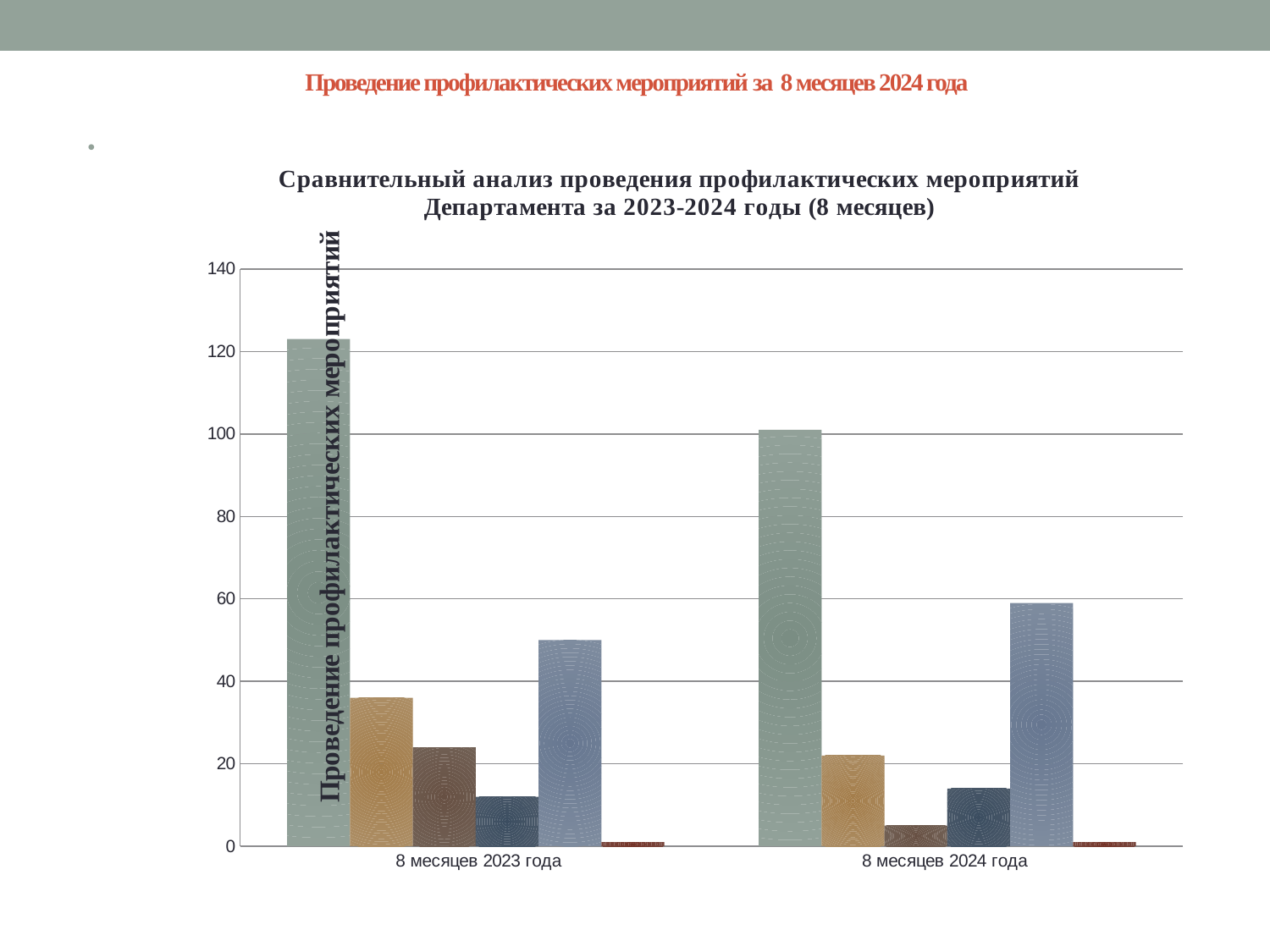
Is the tallest bar for "8 месяцев 2024 года" greater or less than 120? less Is the dark blue bar for "8 месяцев 2023 года" greater or less than 20? less What is the title of the chart? Сравнительный анализ проведения профилактических мероприятий Департамента за 2023-2024 годы (8 месяцев) Is the tallest bar for "8 месяцев 2023 года" greater or less than 100? greater What kind of chart is shown on the slide? bar chart What is the label on the vertical axis of the chart? Проведение профилактических мероприятий Which is taller: the light blue bar for "8 месяцев 2023 года" or the light blue bar for "8 месяцев 2024 года"? 8 месяцев 2024 года Which is taller: the brown bar for "8 месяцев 2023 года" or the brown bar for "8 месяцев 2024 года"? 8 месяцев 2023 года How many categories are shown on the x axis of the chart? 2 How many bars are plotted for the category "8 месяцев 2023 года"? 6 Which is taller: the tallest bar for "8 месяцев 2023 года" or the tallest bar for "8 месяцев 2024 года"? 8 месяцев 2023 года